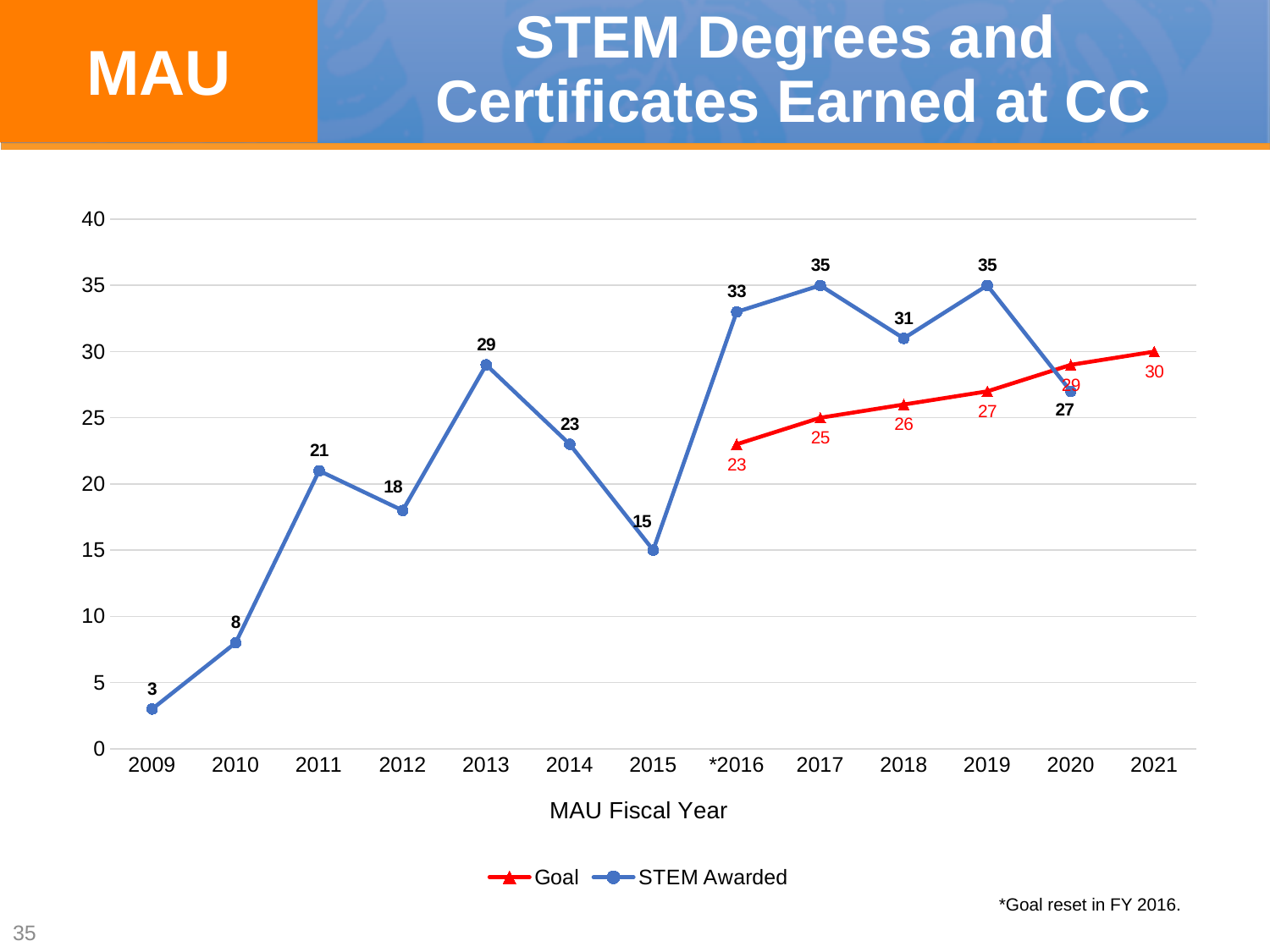
In which year is the STEM Awarded value lowest? 2009 How many series does the legend list? 2 What is the Goal value for 2018? 26 What is the difference between the STEM Awarded value in 2017 and the Goal value in 2017? 10 What is the STEM Awarded value for 2013? 29 How many years are shown on the x axis? 13 Does the Goal line rise or fall from *2016 to 2021? rise What kind of chart is shown on the slide? line chart What is the STEM Awarded value for 2015? 15 What is the highest STEM Awarded value shown? 35 Which is larger in 2020, the Goal value or the STEM Awarded value? Goal What is the label of the x axis? MAU Fiscal Year